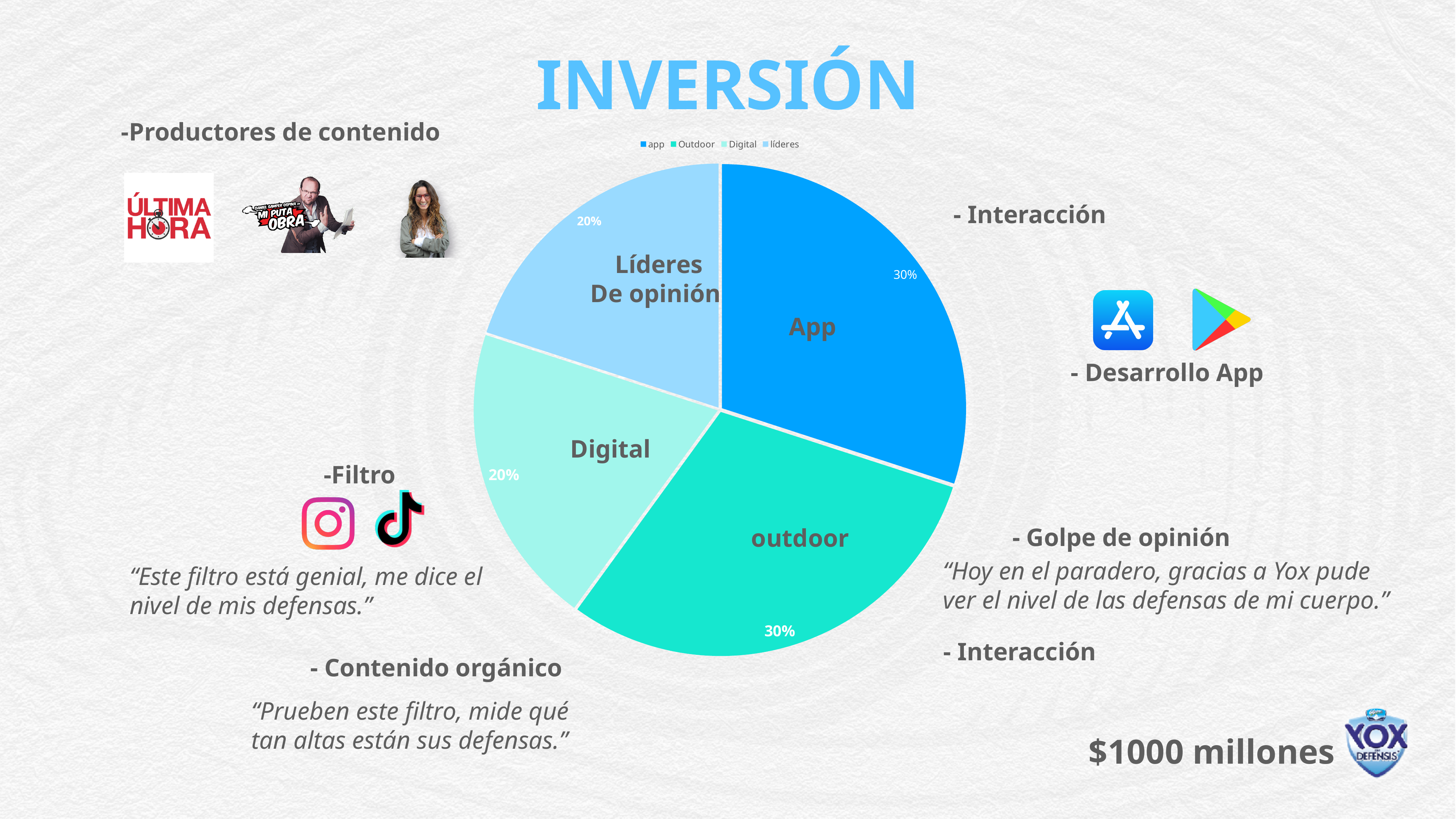
Which is larger, the Líderes de opinión slice or the outdoor slice? outdoor How many entries does the chart legend list? 4 What kind of chart is shown on the slide? pie chart What percentage of the investment goes to App? 30% How many slices does the pie chart have? 4 What percentage of the investment goes to outdoor? 30% What is the combined share of the App and outdoor slices? 60% What is the difference in percentage points between the App slice and the Digital slice? 10% What percentage of the investment goes to Líderes de opinión? 20% Which is larger, the App slice or the Digital slice? App What is the title of the slide containing the pie chart? INVERSIÓN What percentage of the investment goes to Digital? 20%